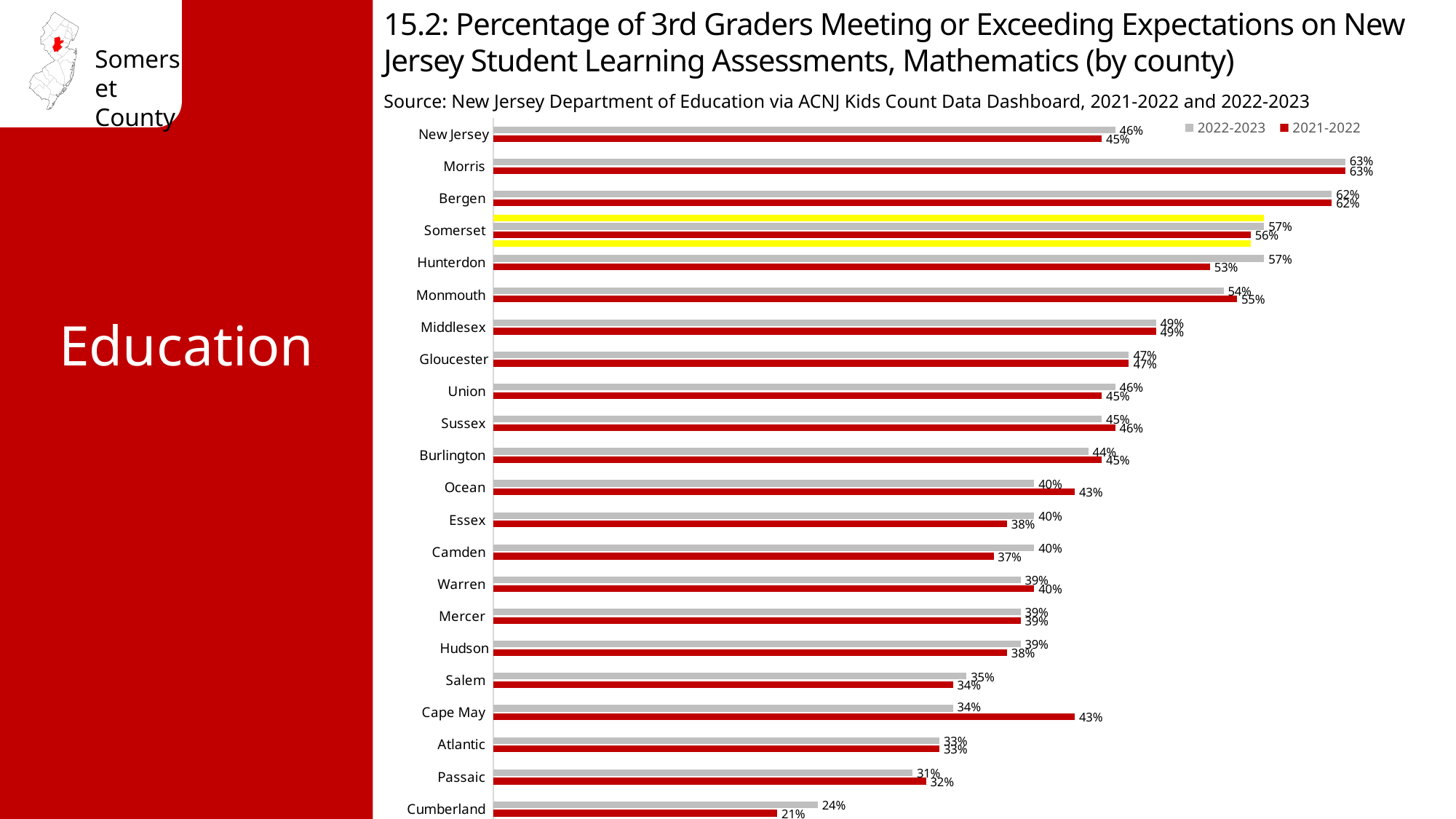
What is the 2022-2023 value for Somerset? 57% What is the difference between the 2022-2023 and 2021-2022 values for Cape May? 9% Which county's bars are highlighted in yellow on the chart? Somerset Which is larger for Ocean: the 2022-2023 value or the 2021-2022 value? 2021-2022 How many counties or regions are listed on the chart? 22 What kind of chart is shown on the slide? Bar chart Which county has the lowest 2021-2022 value? Cumberland What is the 2021-2022 value for Cape May? 43% What is the 2022-2023 value for Hunterdon? 57% Which county has the highest 2022-2023 value? Morris How many series does the legend list? 2 What is the difference between the 2022-2023 and 2021-2022 values for Hunterdon? 4%